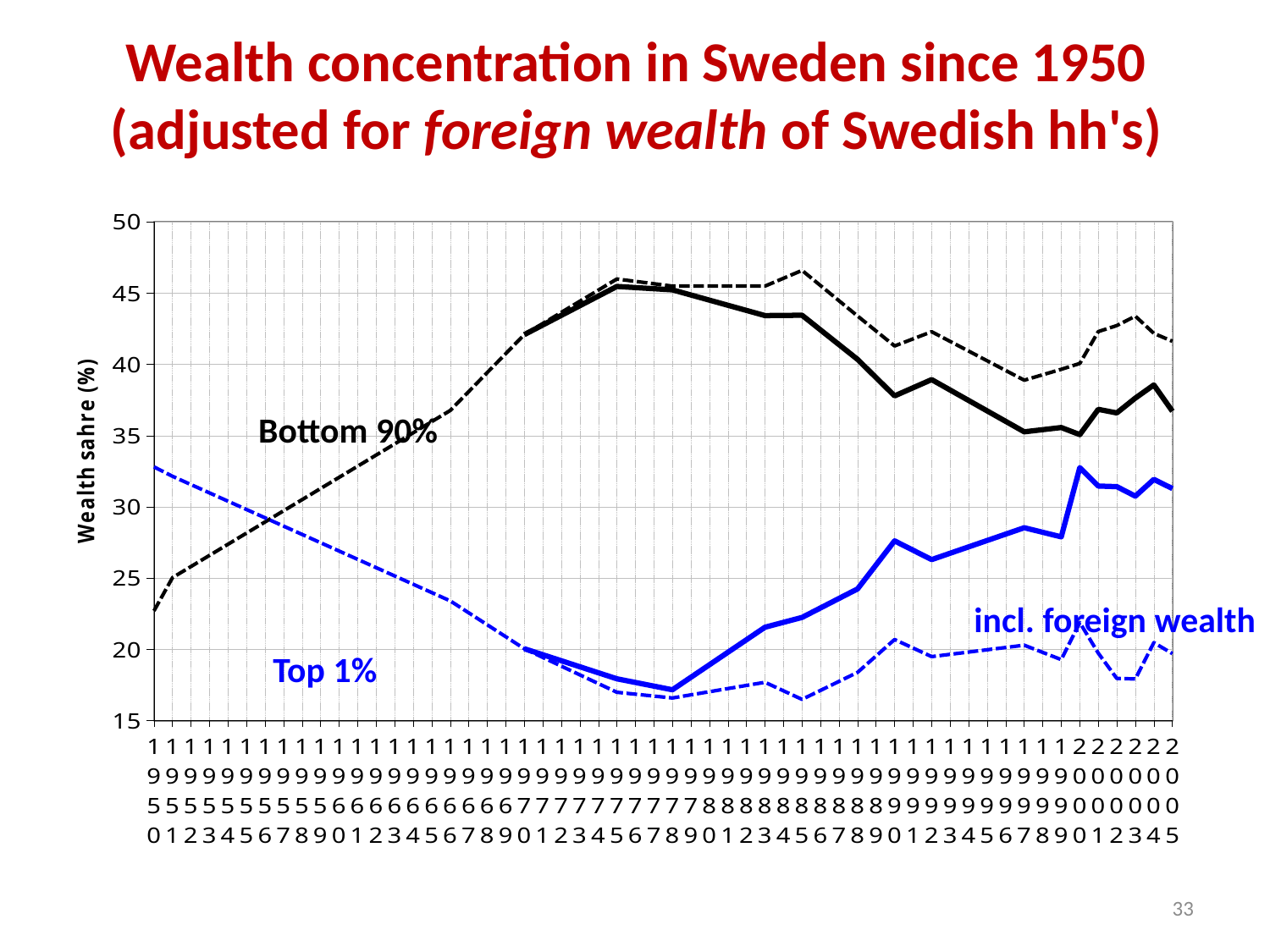
In 2005, which is larger: the solid Bottom 90% line or the solid Top 1% line? Bottom 90% Is the value of the dashed Bottom 90% line in 1950 greater or less than 25? less Is the value of the solid Bottom 90% line in 2005 greater or less than 35? greater Is the value of the solid Top 1% line in 1980 greater or less than 20? less How many years are shown on the x axis of the chart? 56 Does the solid Top 1% line rise or fall between 1980 and 2005? rise What is the title of the chart on the slide? Wealth concentration in Sweden since 1950 (adjusted for foreign wealth of Swedish hh's) What kind of chart is shown on the slide? line chart What label is given to the y axis of the chart? Wealth sahre (%) Does the dashed Top 1% line rise or fall between 1950 and 1980? fall